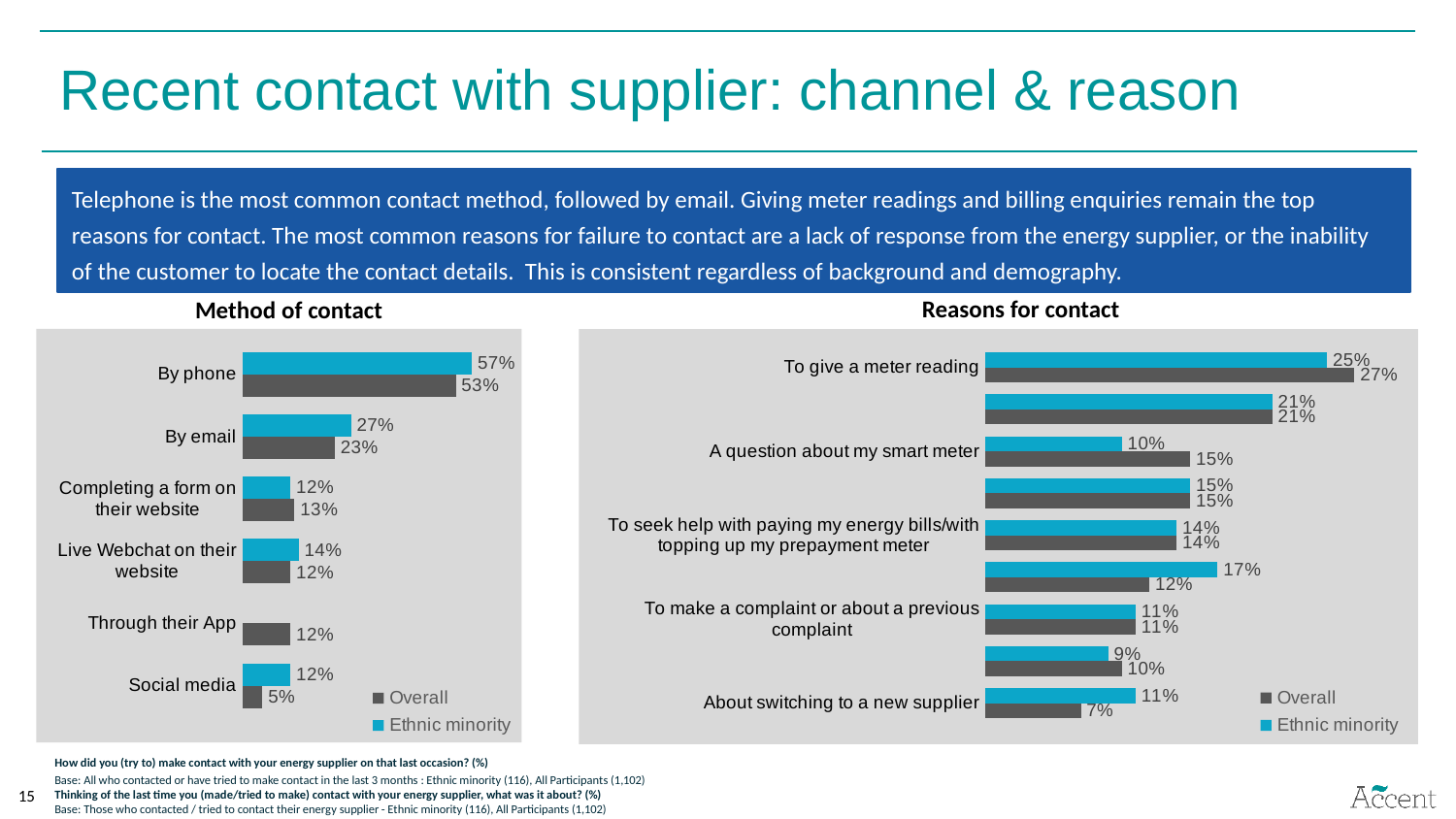
In the 'Method of contact' chart, which category has the lowest Overall value? Social media How many categories are shown in the 'Method of contact' chart? 6 In the 'Method of contact' chart, what is the difference between the Ethnic minority and Overall values for 'By phone'? 4 percentage points In the 'Method of contact' chart, for 'Social media', which series has the larger value, Overall or Ethnic minority? Ethnic minority In the 'Reasons for contact' chart, what is the Ethnic minority value for 'To give a meter reading'? 25% In the 'Method of contact' chart, what is the Overall value for 'By email'? 23% In the 'Reasons for contact' chart, what is the Overall value for 'A question about my smart meter'? 15% In the 'Method of contact' chart, what is the Ethnic minority value for 'By phone'? 57% How many series does the legend of the 'Reasons for contact' chart list? 2 In the 'Reasons for contact' chart, what is the difference between the Ethnic minority and Overall values for 'About switching to a new supplier'? 4 percentage points In the 'Method of contact' chart, which category has the highest Overall value? By phone What type of chart is the 'Reasons for contact' chart? Bar chart